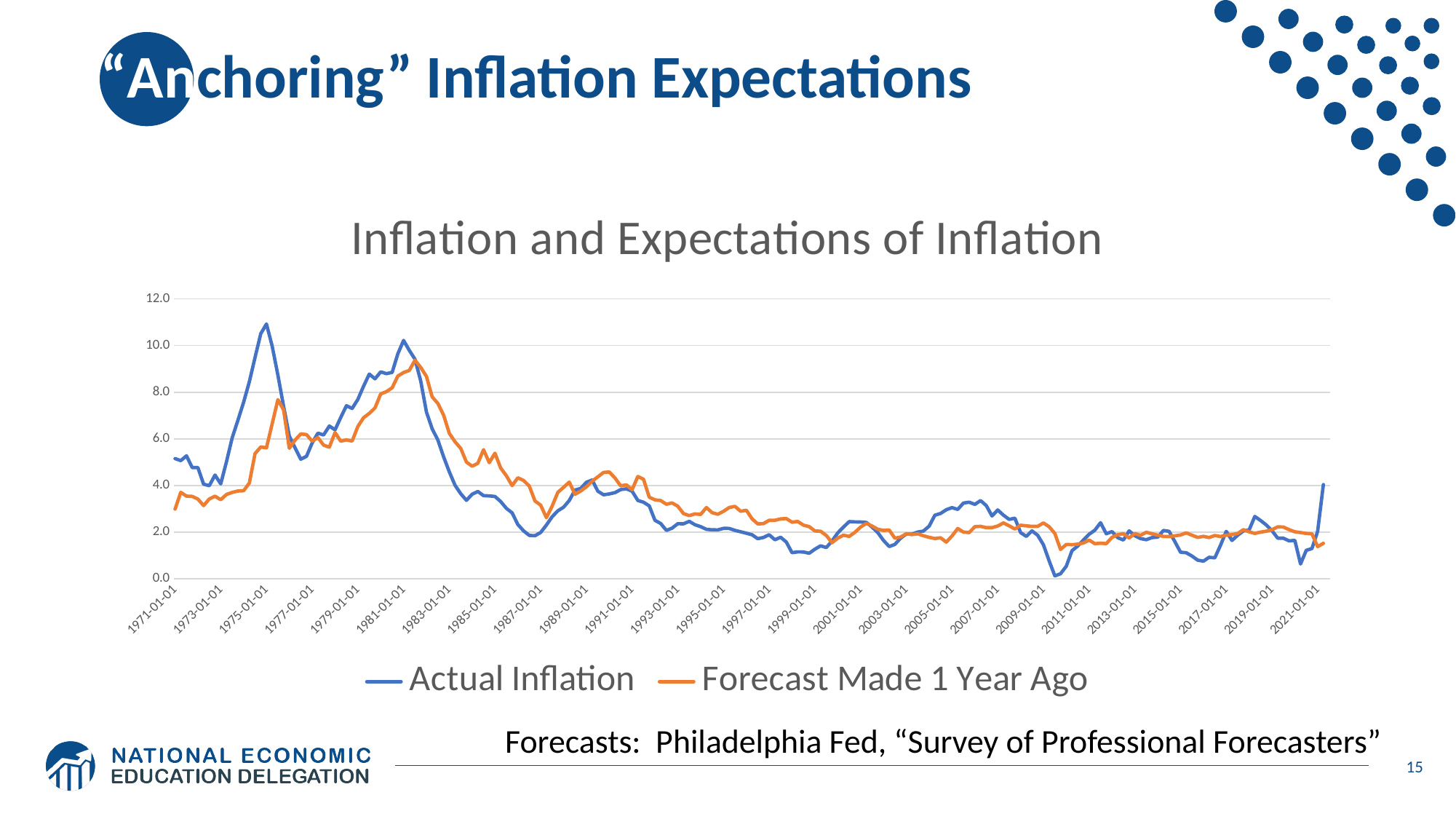
Is the peak value of Forecast Made 1 Year Ago around 1975 greater or less than 8.0? less Is the peak value of Forecast Made 1 Year Ago around 1982 greater or less than 8.0? greater What kind of chart is shown on the slide? Line chart What is the title of the chart? Inflation and Expectations of Inflation How many series does the legend list? 2 Around 1975, which series reaches the higher value, Actual Inflation or Forecast Made 1 Year Ago? Actual Inflation Is the peak value of Actual Inflation around 1975 greater or less than 10.0? greater Which series is drawn in orange? Forecast Made 1 Year Ago Does Actual Inflation generally rise or fall between 1973 and 1975? rise Does Actual Inflation generally rise or fall between 1981 and 1987? fall Around 1987, which series is higher, Actual Inflation or Forecast Made 1 Year Ago? Forecast Made 1 Year Ago